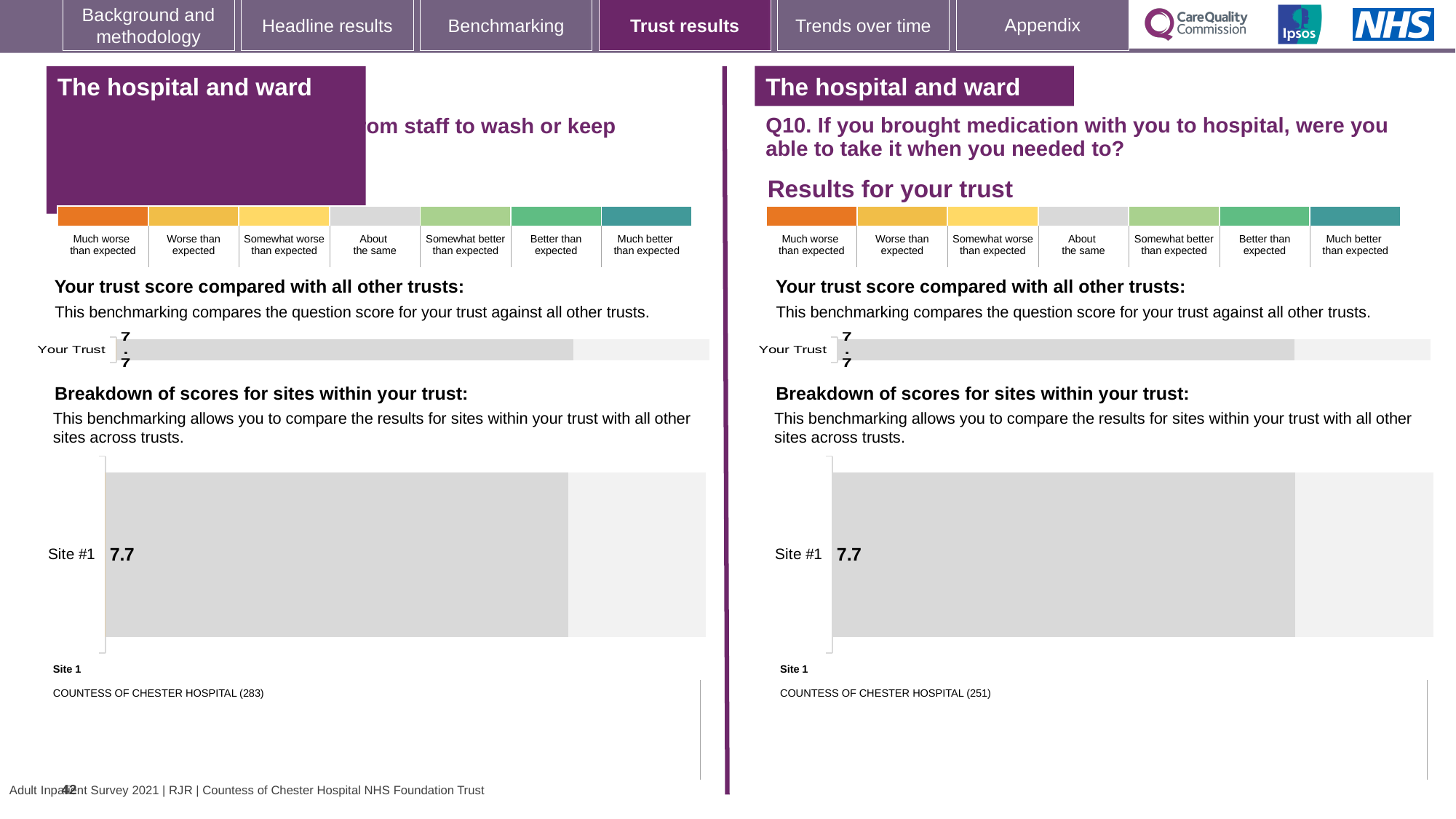
Is the Site #1 score on the right panel (Q10) larger than, smaller than, or equal to the Site #1 score on the left panel? equal On the right panel (Q10), what is the score shown for Site #1 in the breakdown of scores for sites within your trust? 7.7 What is the difference between the 'Your Trust' score and the Site #1 score on the right panel (Q10)? 0 On the left panel, what is the score shown for Site #1 in the breakdown of scores for sites within your trust? 7.7 On the left panel, what score is shown for 'Your Trust' in the trust score comparison chart? 7.7 On the right panel (Q10), what score is shown for 'Your Trust' in the trust score comparison chart? 7.7 Which site name is listed under Site 1 on the right panel (Q10)? COUNTESS OF CHESTER HOSPITAL (251) Which site name is listed under Site 1 on the left panel? COUNTESS OF CHESTER HOSPITAL (283) How many sites are plotted in the breakdown of scores chart on the left panel? 1 How many sites are plotted in the breakdown of scores chart on the right panel (Q10)? 1 What kind of chart is used to show the Site #1 score on the right panel (Q10)? bar chart